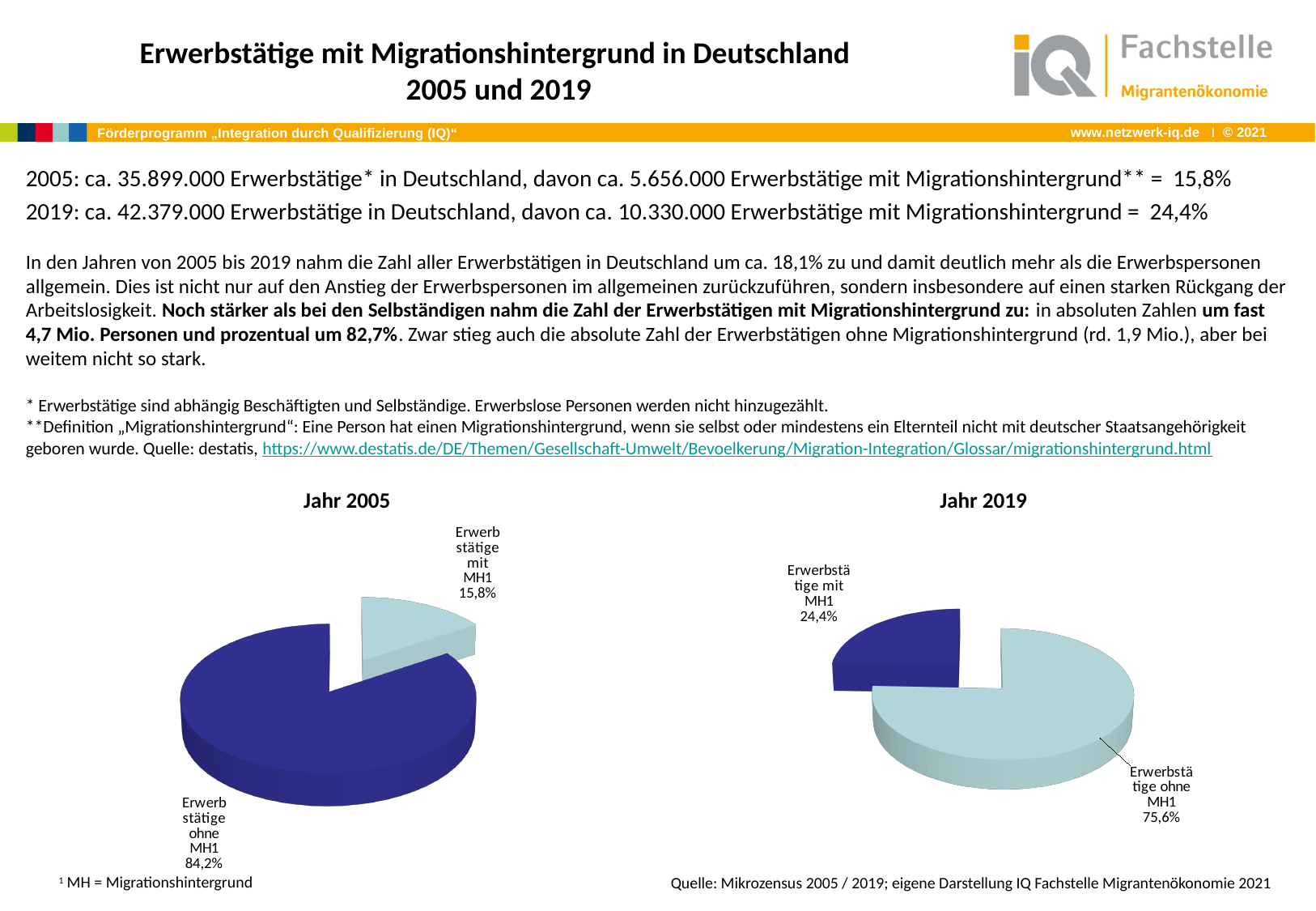
In the "Jahr 2005" chart, what share is shown for Erwerbstätige ohne MH1? 84,2% In the "Jahr 2005" chart, what is the difference between the share of Erwerbstätige ohne MH1 and Erwerbstätige mit MH1? 68,4 percentage points In the "Jahr 2019" chart, what share is shown for Erwerbstätige ohne MH1? 75,6% In the "Jahr 2005" chart, which slice is the largest? Erwerbstätige ohne MH1 In the "Jahr 2019" chart, what colour is the slice for Erwerbstätige mit MH1? Dark blue Is the share of Erwerbstätige mit MH1 larger in the "Jahr 2005" chart or in the "Jahr 2019" chart? Jahr 2019 In the "Jahr 2019" chart, what share is shown for Erwerbstätige mit MH1? 24,4% How many slices does the "Jahr 2019" chart have? 2 What type of chart is the "Jahr 2005" chart? Pie chart In the "Jahr 2005" chart, what share is shown for Erwerbstätige mit MH1? 15,8% What is the title of the chart on the right side of the slide? Jahr 2019 In the "Jahr 2019" chart, which slice is the smallest? Erwerbstätige mit MH1